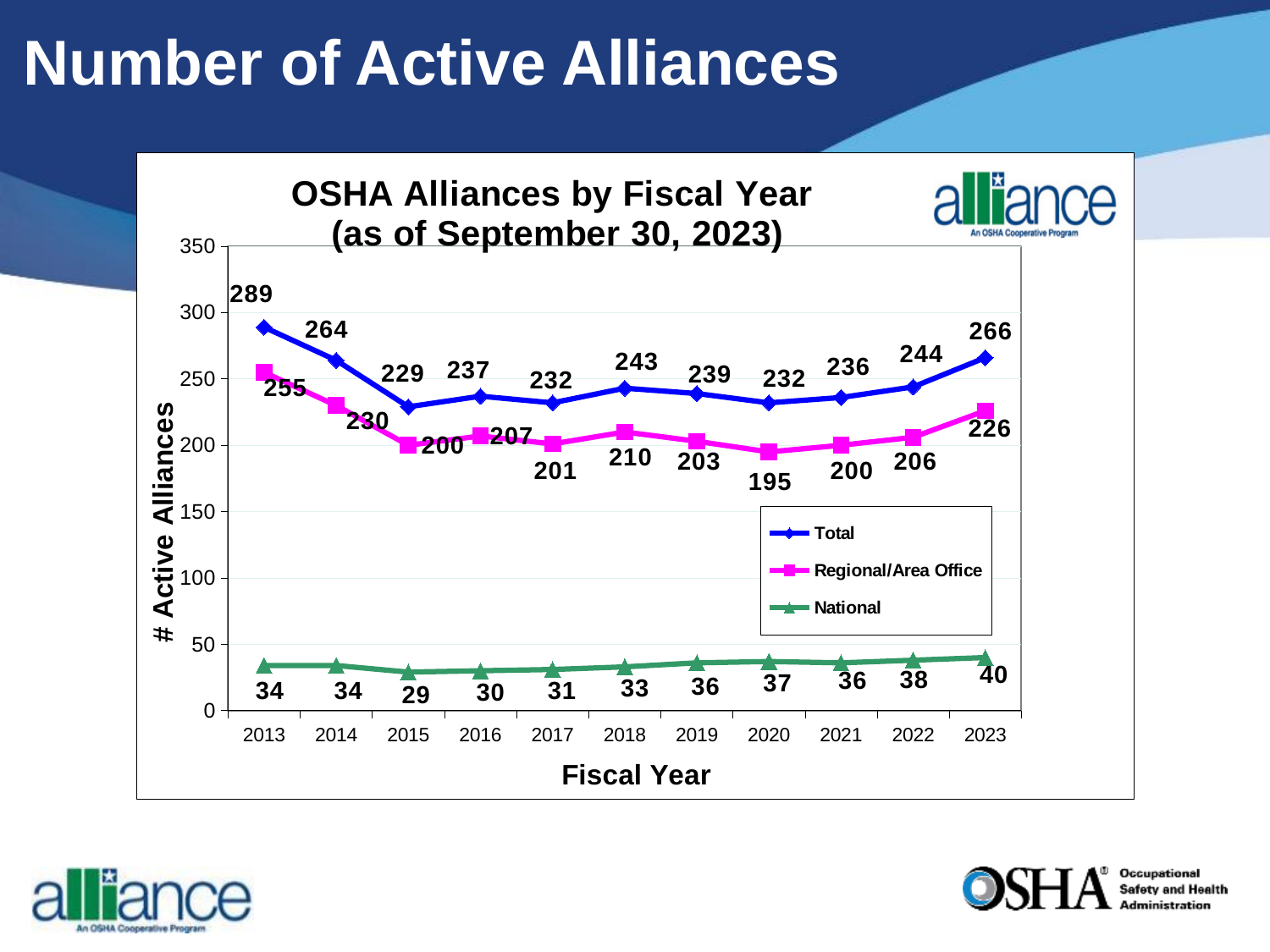
In which fiscal year is the Total series at its highest? 2013 What is the difference between the Total and Regional/Area Office values in fiscal year 2023? 40 What is the title of the chart? OSHA Alliances by Fiscal Year (as of September 30, 2023) What is the National value for fiscal year 2023? 40 How many fiscal years are shown on the x axis? 11 What kind of chart is shown on the slide? line chart What is the Total number of active alliances in fiscal year 2013? 289 Is the Regional/Area Office value for 2013 greater or less than 250? greater Which is larger, the Total value for 2018 or the Total value for 2019? 2018 In which fiscal year is the National series at its lowest? 2015 What is the Regional/Area Office value for fiscal year 2020? 195 How many series does the legend list? 3